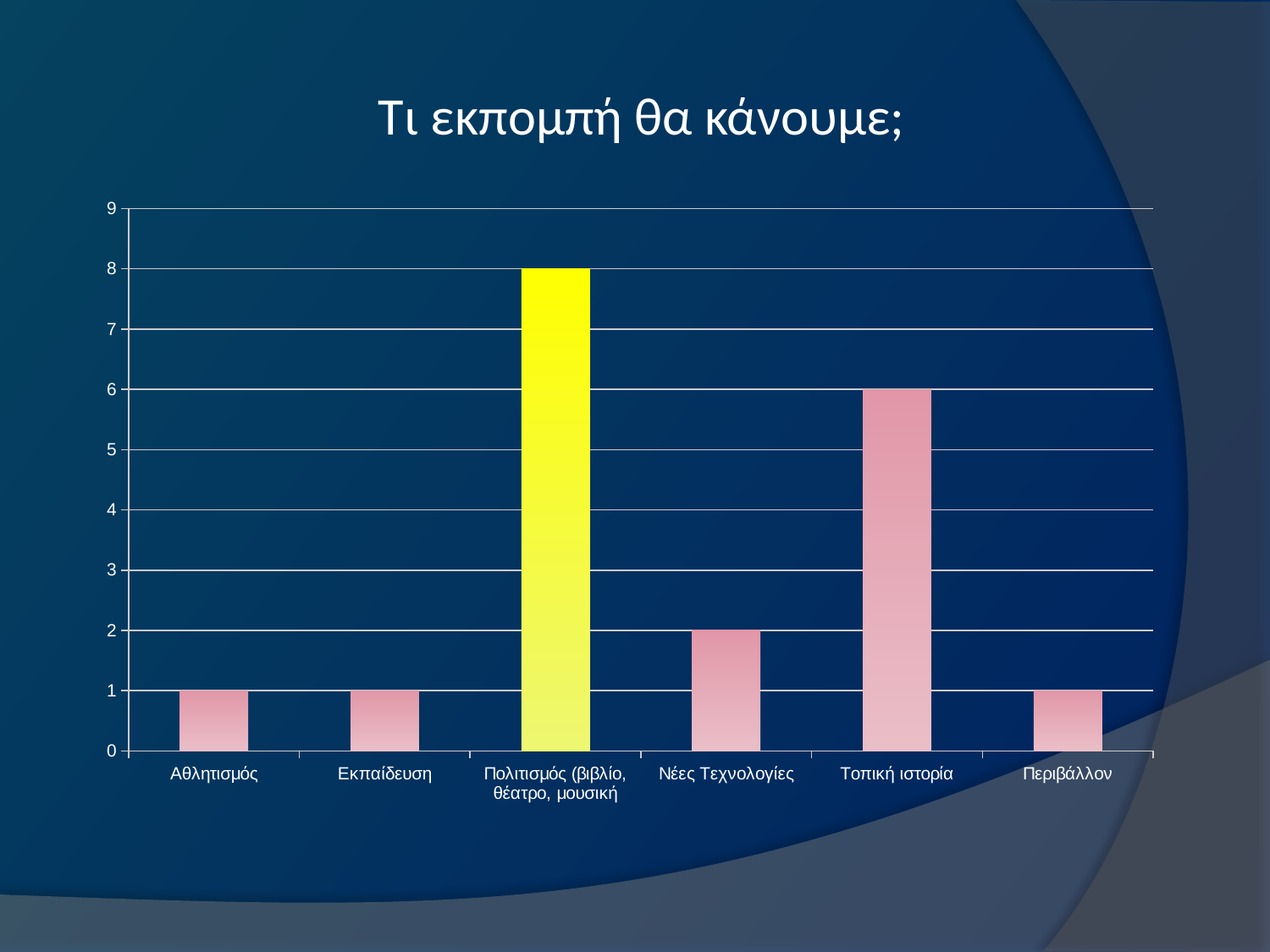
What is the difference between the values for Πολιτισμός (βιβλίο, θέατρο, μουσική) and Τοπική ιστορία? 2 What type of chart is shown on the slide? Bar chart What is the value for Αθλητισμός? 1 Which is larger, the value for Τοπική ιστορία or the value for Νέες Τεχνολογίες? Τοπική ιστορία What is the value for Νέες Τεχνολογίες? 2 What is the title of the chart? Τι εκπομπή θα κάνουμε; What is the value for Πολιτισμός (βιβλίο, θέατρο, μουσική)? 8 Which category has the highest value? Πολιτισμός (βιβλίο, θέατρο, μουσική) Which bar is coloured yellow? Πολιτισμός (βιβλίο, θέατρο, μουσική) What is the value for Τοπική ιστορία? 6 How many categories are shown on the x axis? 6 Is the value for Τοπική ιστορία greater or less than 5? greater